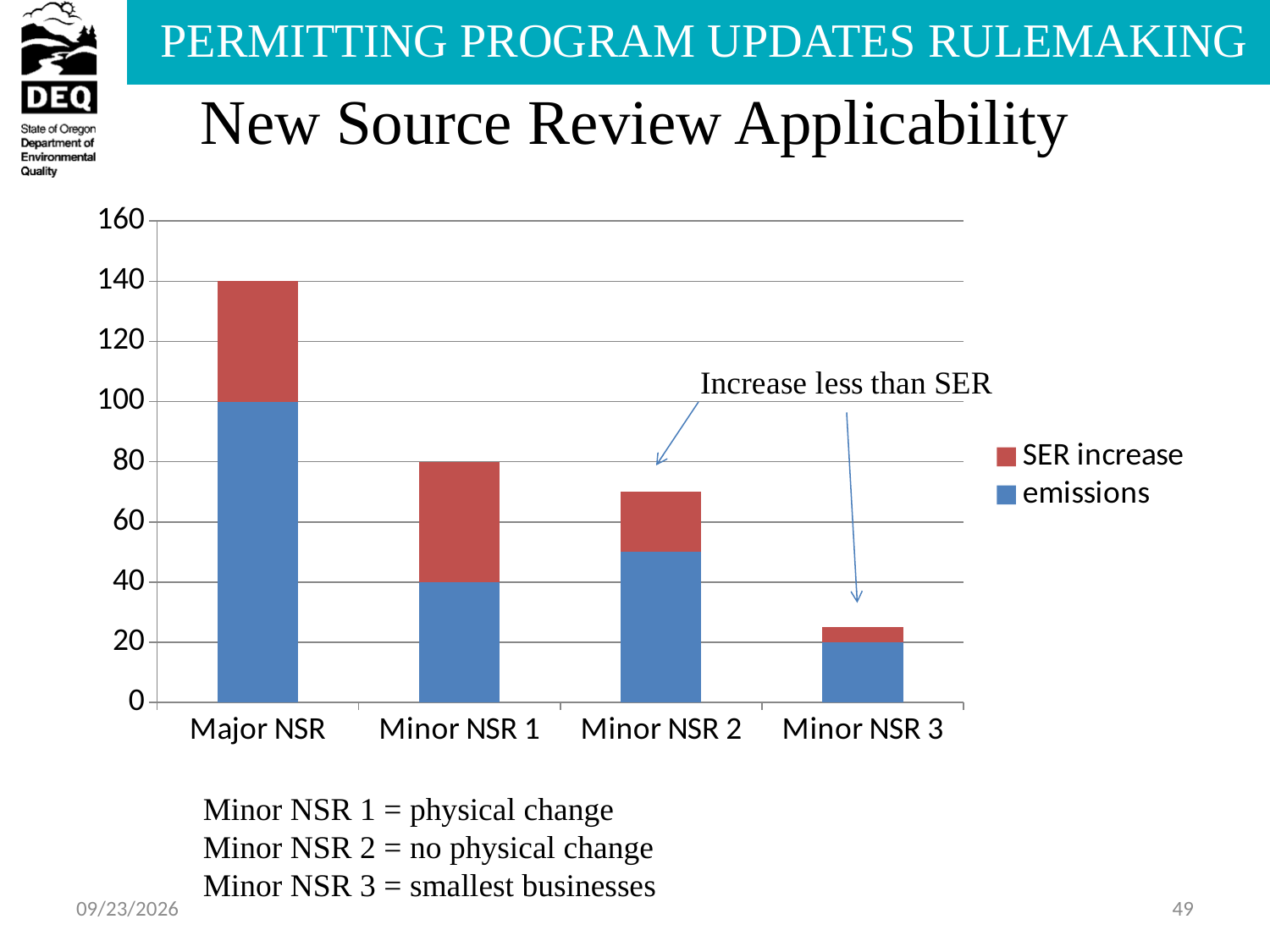
Which category has the lowest total stacked bar? Minor NSR 3 Which category has the highest total stacked bar? Major NSR What is the total height of the stacked bar for Minor NSR 1? 80 What is the emissions value for Minor NSR 3? 20 How many series does the chart legend list? 2 What is the emissions value for Major NSR? 100 What type of chart is shown on the slide? Stacked bar chart Is the total stacked value for Minor NSR 2 greater or less than 60? greater How many categories are shown on the x axis of the chart? 4 Do the total bar heights rise or fall from Major NSR to Minor NSR 3? Fall What is the emissions value for Minor NSR 1? 40 What is the total height of the stacked bar for Major NSR? 140